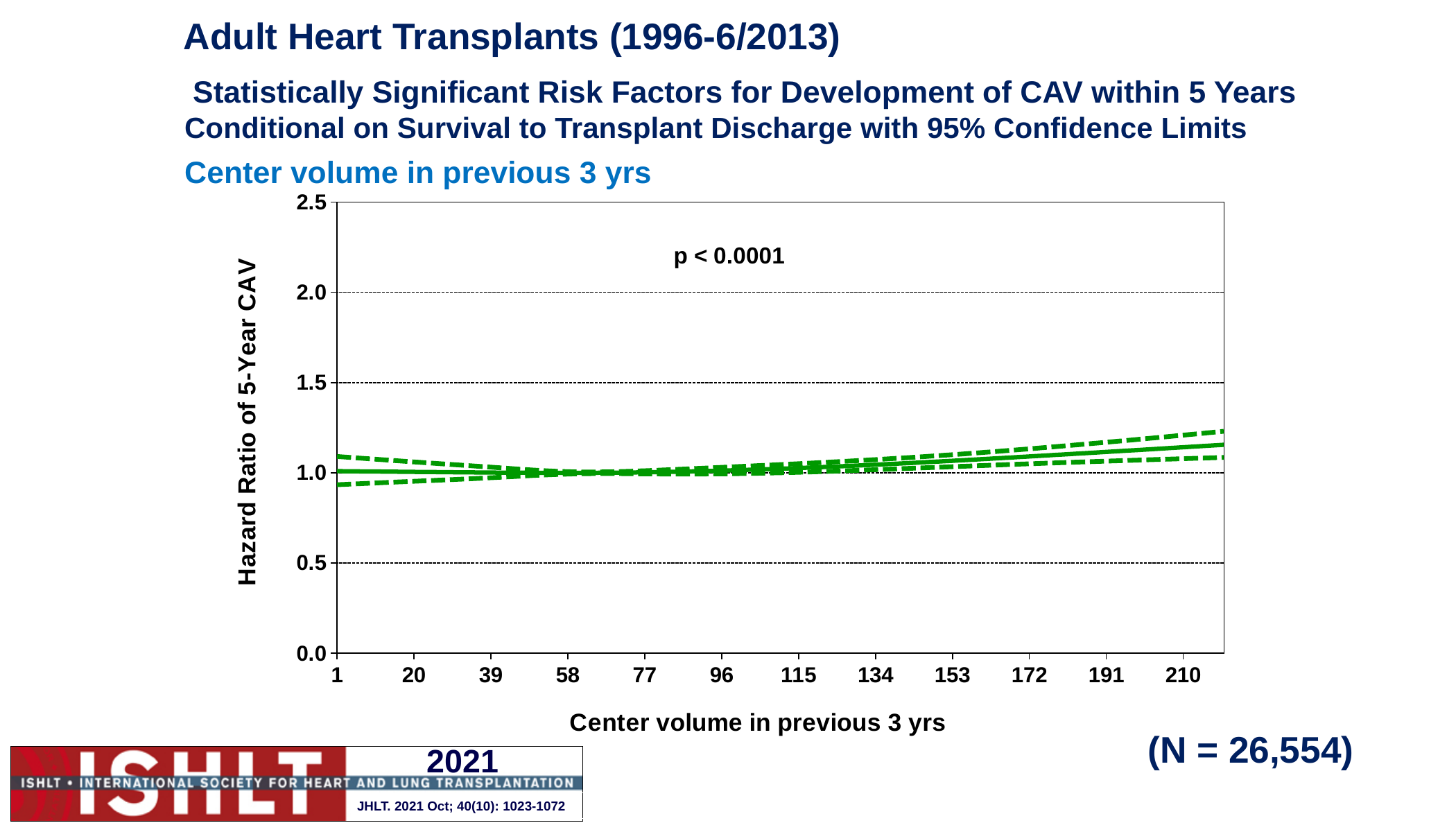
What is the highest value labelled on the y axis of the chart? 2.5 What p-value is printed on the chart? p < 0.0001 What is the label of the y axis of the chart? Hazard Ratio of 5-Year CAV How many tick labels are shown on the x axis of the chart? 12 Is the upper 95% confidence limit at a center volume of 210 greater or less than 1.5? less How many lines are plotted on the chart (estimate plus confidence limits)? 3 What kind of chart is shown on the slide? line chart Is the hazard ratio of 5-year CAV at a center volume of 210 greater or less than 1.0? greater Is the hazard ratio of 5-year CAV at a center volume of 210 greater or less than 2.0? less Does the hazard ratio of 5-year CAV rise or fall as center volume increases from 58 to 210? rise What is the largest center volume labelled on the x axis of the chart? 210